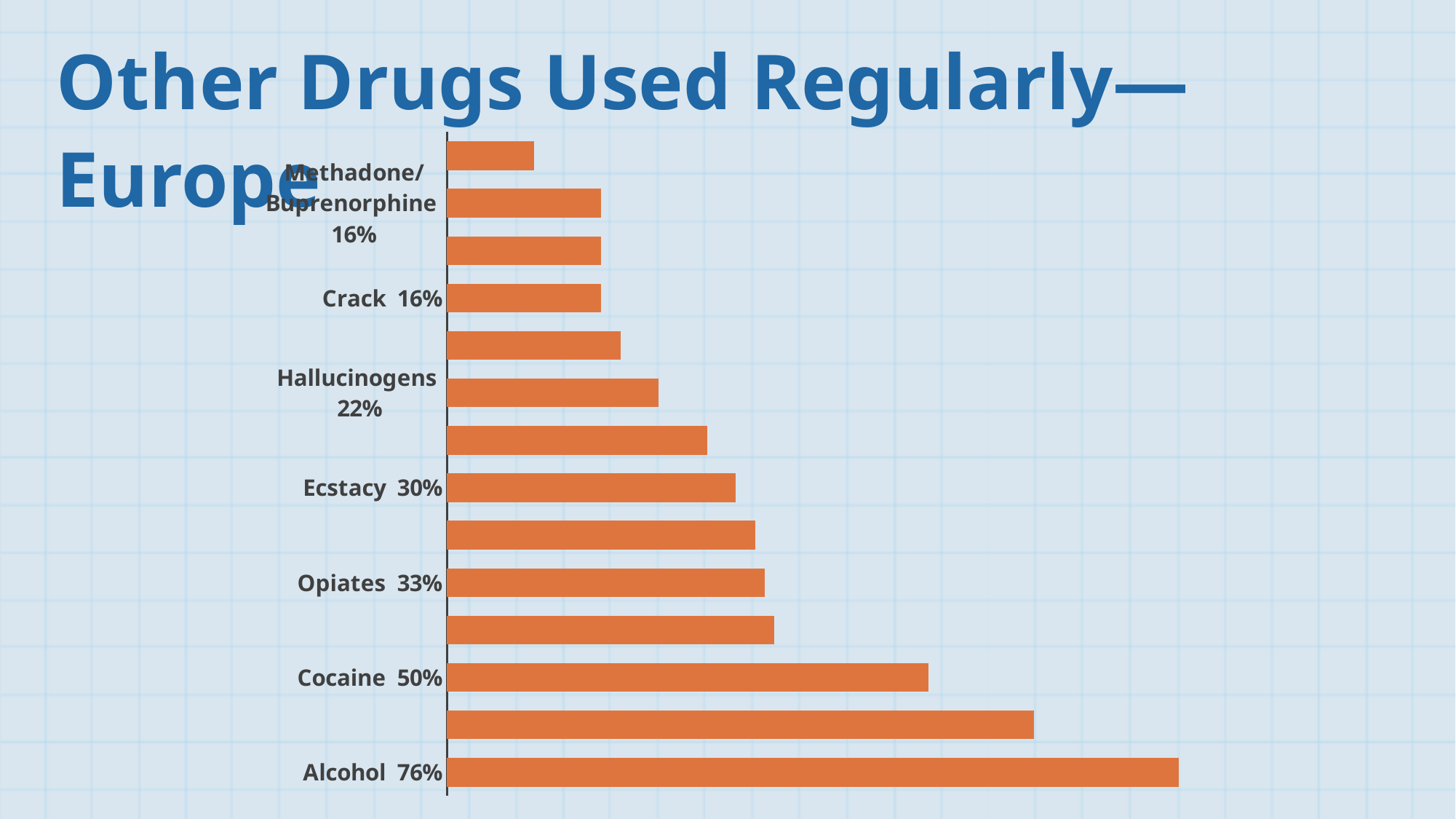
What is the title of the slide? Other Drugs Used Regularly—Europe What is the difference between the values for Alcohol and Cocaine? 26 percentage points What is the difference between the values for Ecstacy and Hallucinogens? 8 percentage points What is the value for Alcohol? 76% What kind of chart is shown on the slide? Bar chart What is the value for Opiates? 33% Which is larger, the value for Cocaine or the value for Opiates? Cocaine Which labeled category has the highest value? Alcohol Do the bars get longer or shorter going from the top of the chart to the bottom? Longer What is the value for Methadone/Buprenorphine? 16% What is the value for Hallucinogens? 22% What is the value for Cocaine? 50%